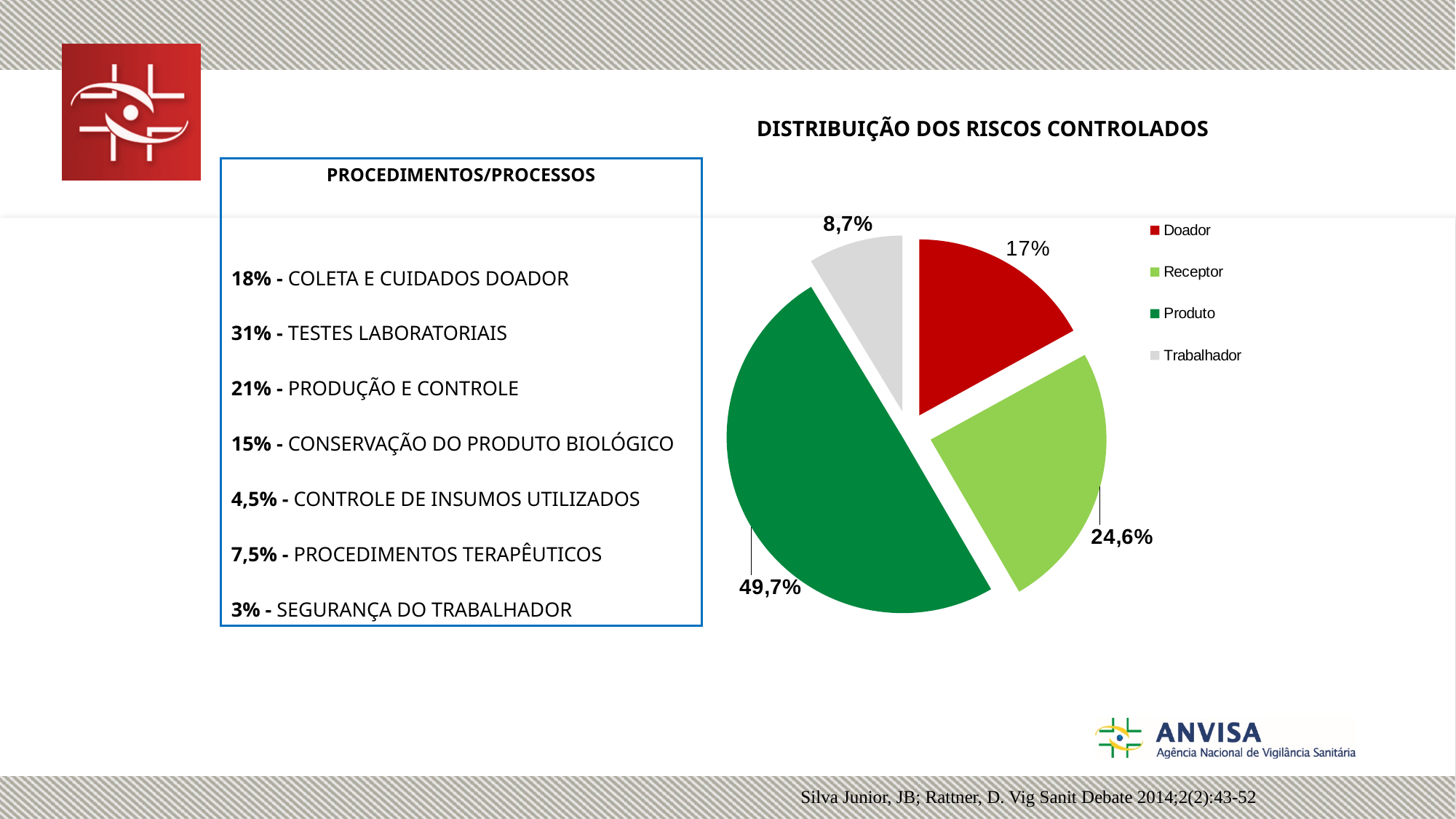
What type of chart is shown on the slide? pie chart Which category has the smallest slice of the pie? Trabalhador What is the value shown for the Trabalhador slice? 8,7% Which category has the largest slice of the pie? Produto What is the value shown for the Doador slice? 17% How many slices does the pie chart have? 4 Which slice is larger, Doador or Receptor? Receptor What is the title of the chart? DISTRIBUIÇÃO DOS RISCOS CONTROLADOS What percentage of the pie does the Produto slice represent? 49,7% How many entries does the legend list? 4 What is the difference in percentage points between the Produto and Receptor slices? 25,1% What is the value shown for the Receptor slice? 24,6%